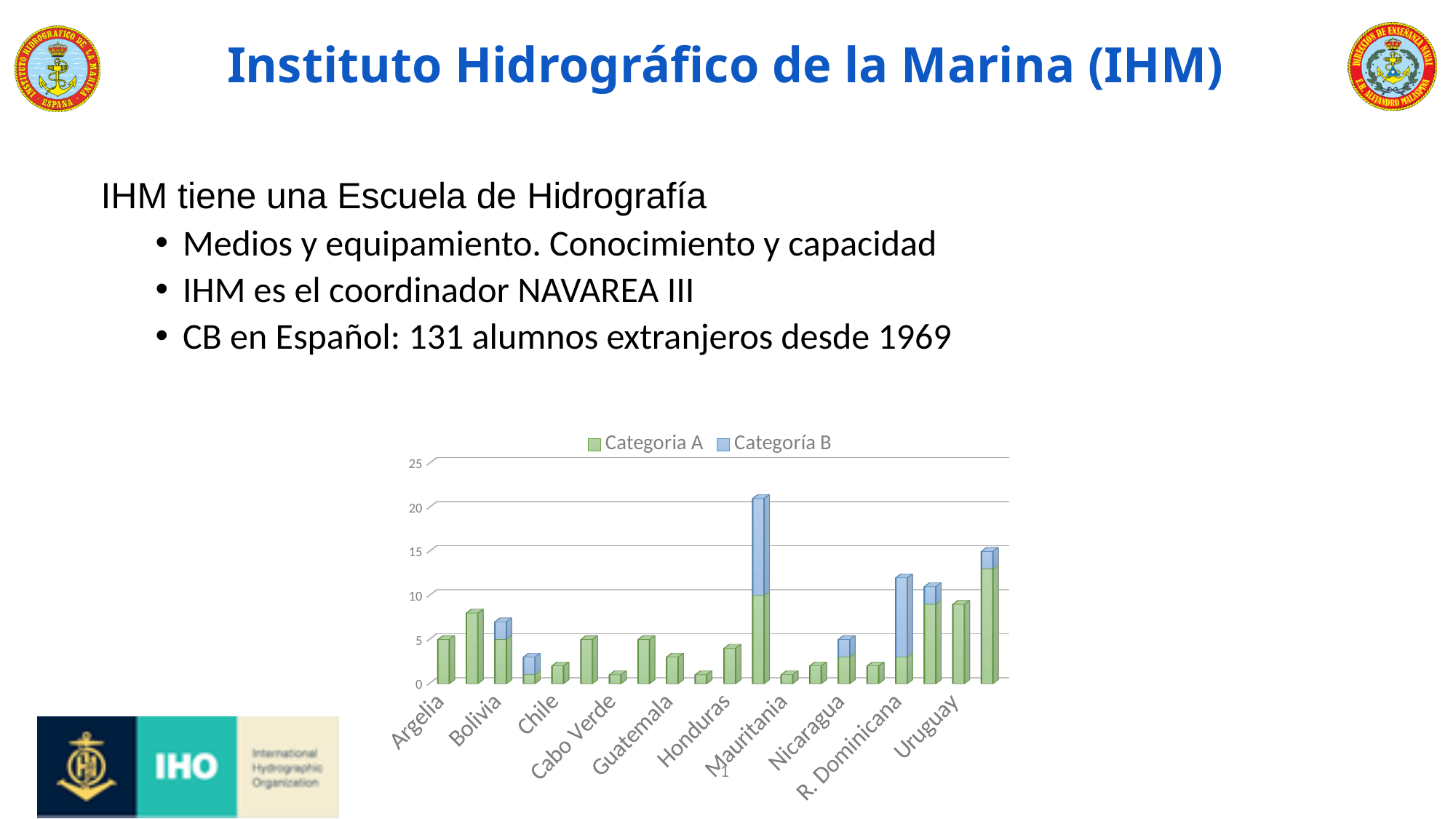
Which colour represents Categoría B in the chart? blue Is the total value for Guatemala greater or less than 5? less What kind of chart is shown on the slide? bar chart Is the total value for Uruguay greater or less than 5? greater Which has the larger total value, Argelia or Mauritania? Argelia How many series does the chart legend list? 2 Which has the larger total value, R. Dominicana or Argelia? R. Dominicana Is the total value for Argelia greater or less than 10? less What are the two series named in the chart legend? Categoria A and Categoría B How many country labels are shown on the x axis of the chart? 10